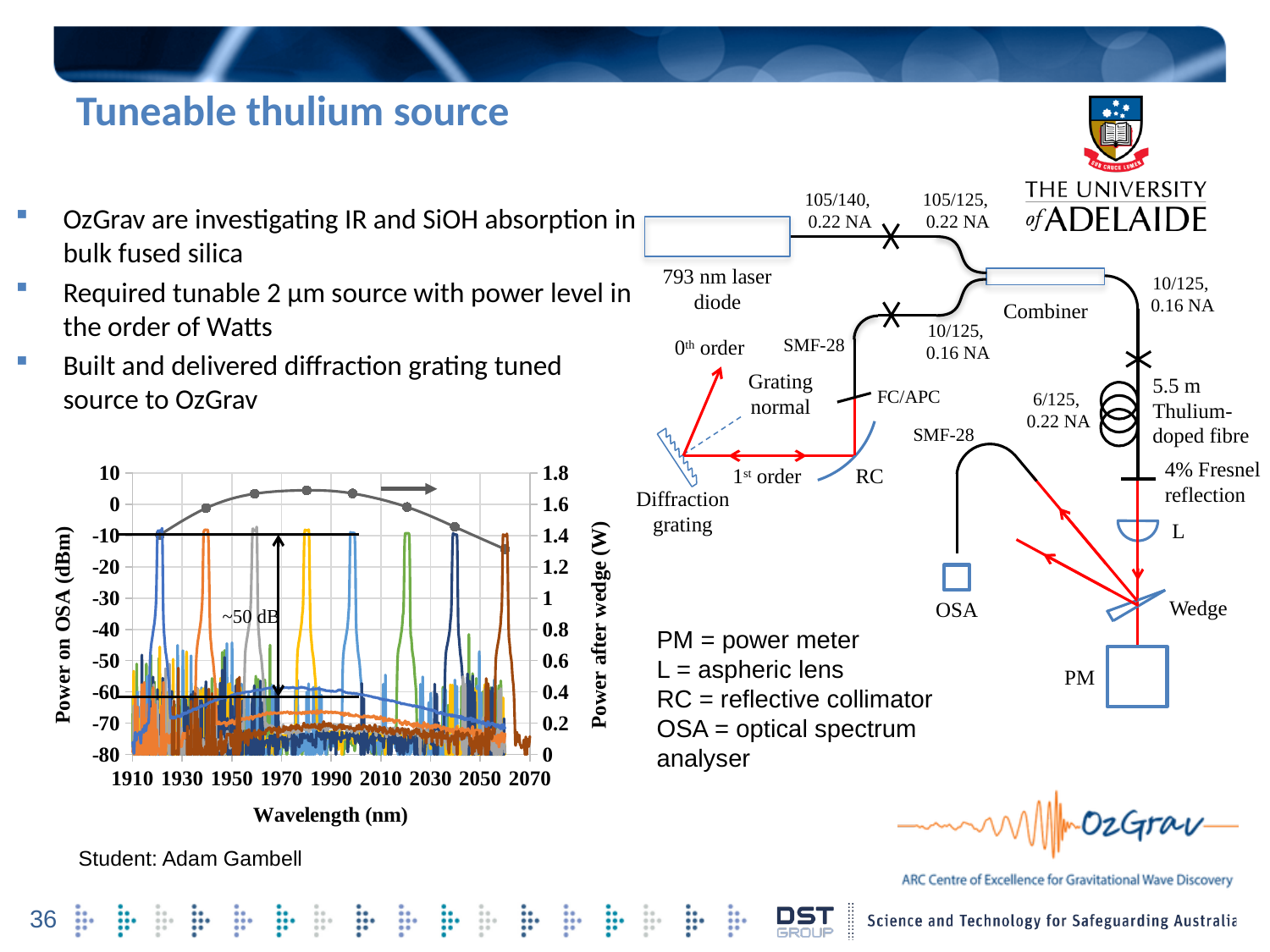
How many data points are marked on the power after wedge curve? 8 Does the power after wedge rise or fall as wavelength increases from 1920 nm to 1980 nm? rise Which is larger: the power after wedge at 1980 nm or at 2040 nm? 1980 nm What is the label of the right-hand y axis of the chart? Power after wedge (W) Is the peak power on the OSA of the spectrum near 1940 nm greater or less than -30 dBm? greater At which wavelength does the power after wedge curve reach its highest value? 1980 nm What kind of chart is shown on the slide? line chart Does the power after wedge rise or fall as wavelength increases from 1980 nm to 2060 nm? fall Is the power after wedge at 1920 nm greater or less than 1.6 W? less Is the power after wedge at 2060 nm greater or less than 1.6 W? less What is the label of the x axis of the chart? Wavelength (nm)